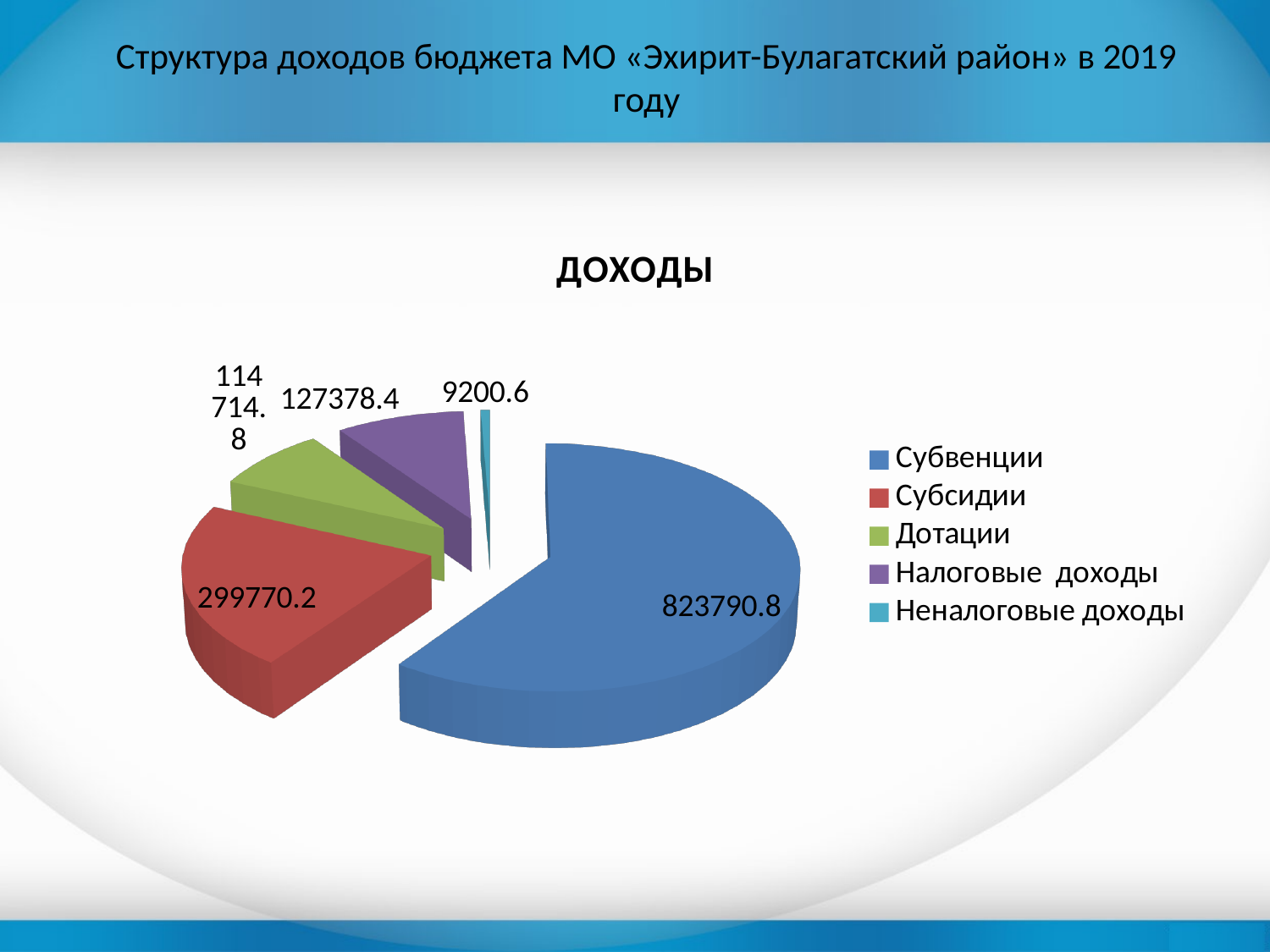
What is the value for Субвенции? 823790.8 What is the value for Субсидии? 299770.2 What is the difference between the values for Субвенции and Субсидии? 524020.6 How many slices does the pie chart have? 5 How many entries does the legend list? 5 What is the value for Налоговые доходы? 127378.4 Which category has the smallest slice? Неналоговые доходы Which category has the largest slice? Субвенции What is the value for Неналоговые доходы? 9200.6 Which is larger, Дотации or Налоговые доходы? Налоговые доходы What is the title of the chart? ДОХОДЫ What type of chart is shown on the slide? Pie chart